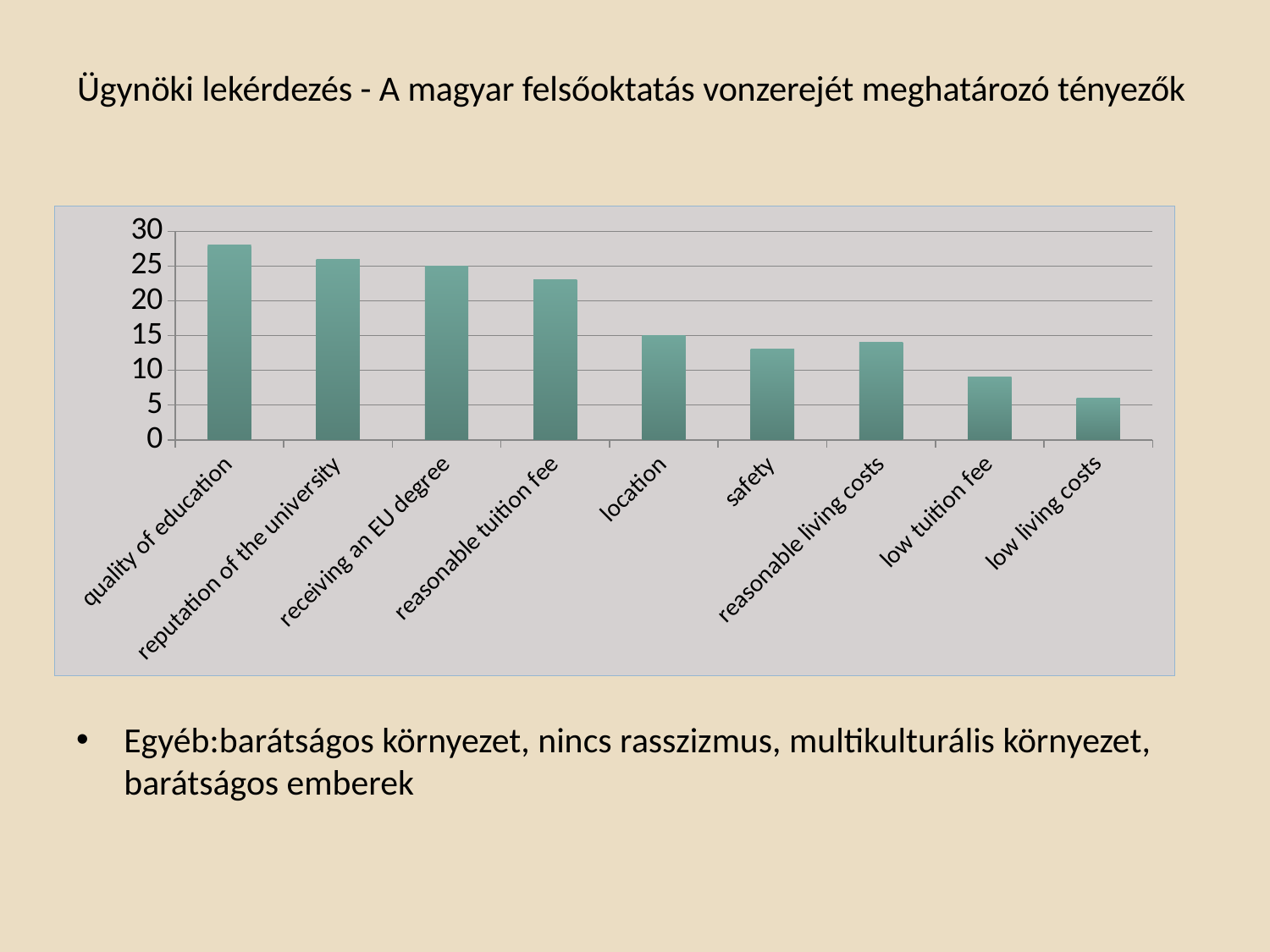
How many categories are shown on the x axis of the chart? 9 Which category has the highest value in the chart? quality of education Which category has the lowest value in the chart? low living costs What kind of chart is shown on the slide? bar chart Is the value for low tuition fee greater or less than 10? less Is the value for quality of education greater or less than 25? greater Do the values generally rise or fall from left to right along the x axis? fall Is the value for reasonable tuition fee greater or less than 20? greater Which is larger, the value for reputation of the university or the value for location? reputation of the university What is the highest value shown on the vertical axis of the chart? 30